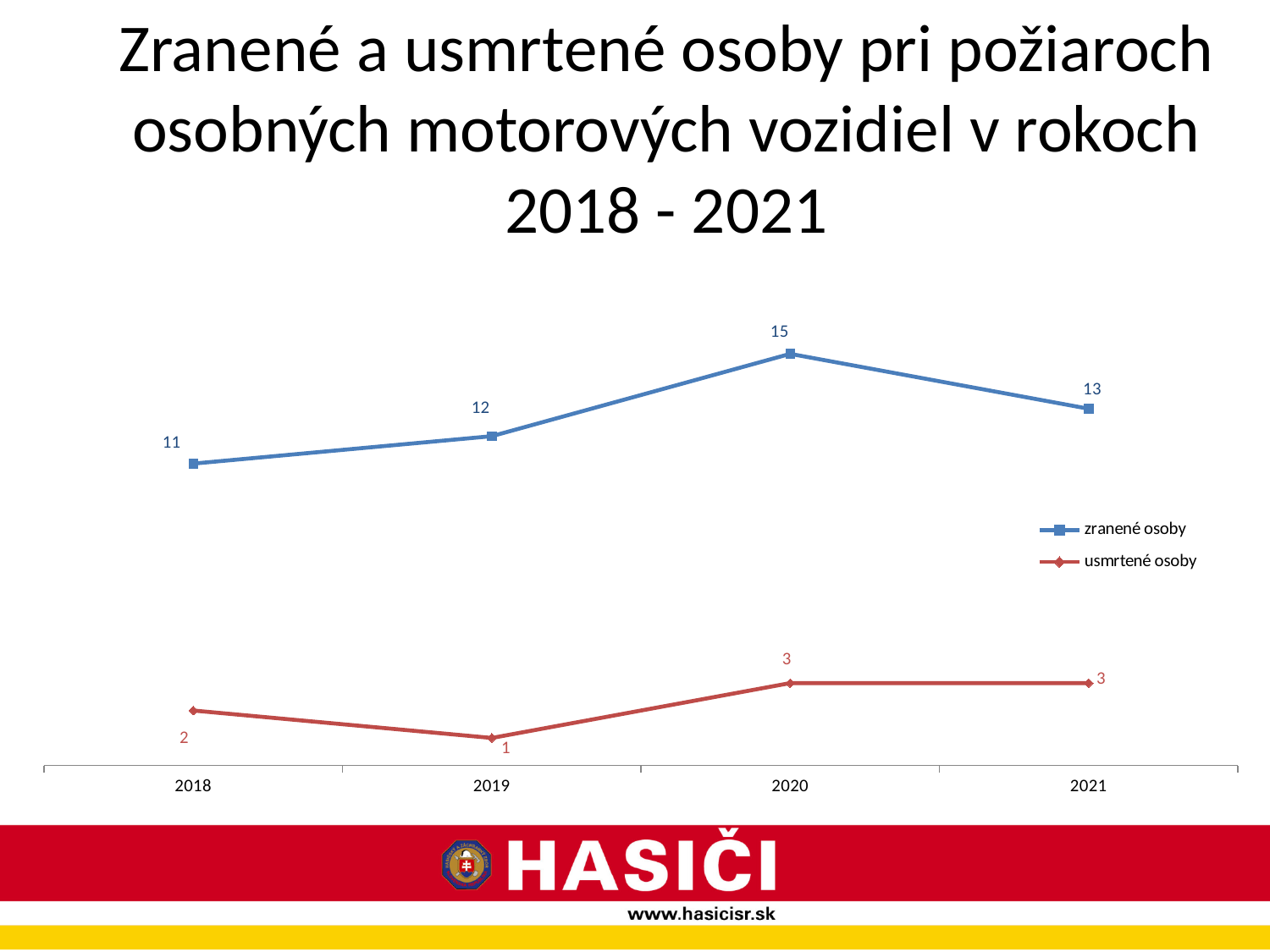
Which colour is used for the usmrtené osoby series? red How many years are shown on the x axis? 4 What is the value for usmrtené osoby in 2019? 1 What is the value for zranené osoby in 2020? 15 Does the value for zranené osoby rise or fall from 2018 to 2020? rise In which year is the value for zranené osoby highest? 2020 How many series does the legend list? 2 What is the difference between zranené osoby in 2020 and in 2018? 4 In which year is the value for usmrtené osoby lowest? 2019 What is the value for zranené osoby in 2018? 11 What kind of chart is shown on the slide? line chart Which is larger: zranené osoby in 2021 or zranené osoby in 2019? zranené osoby in 2021